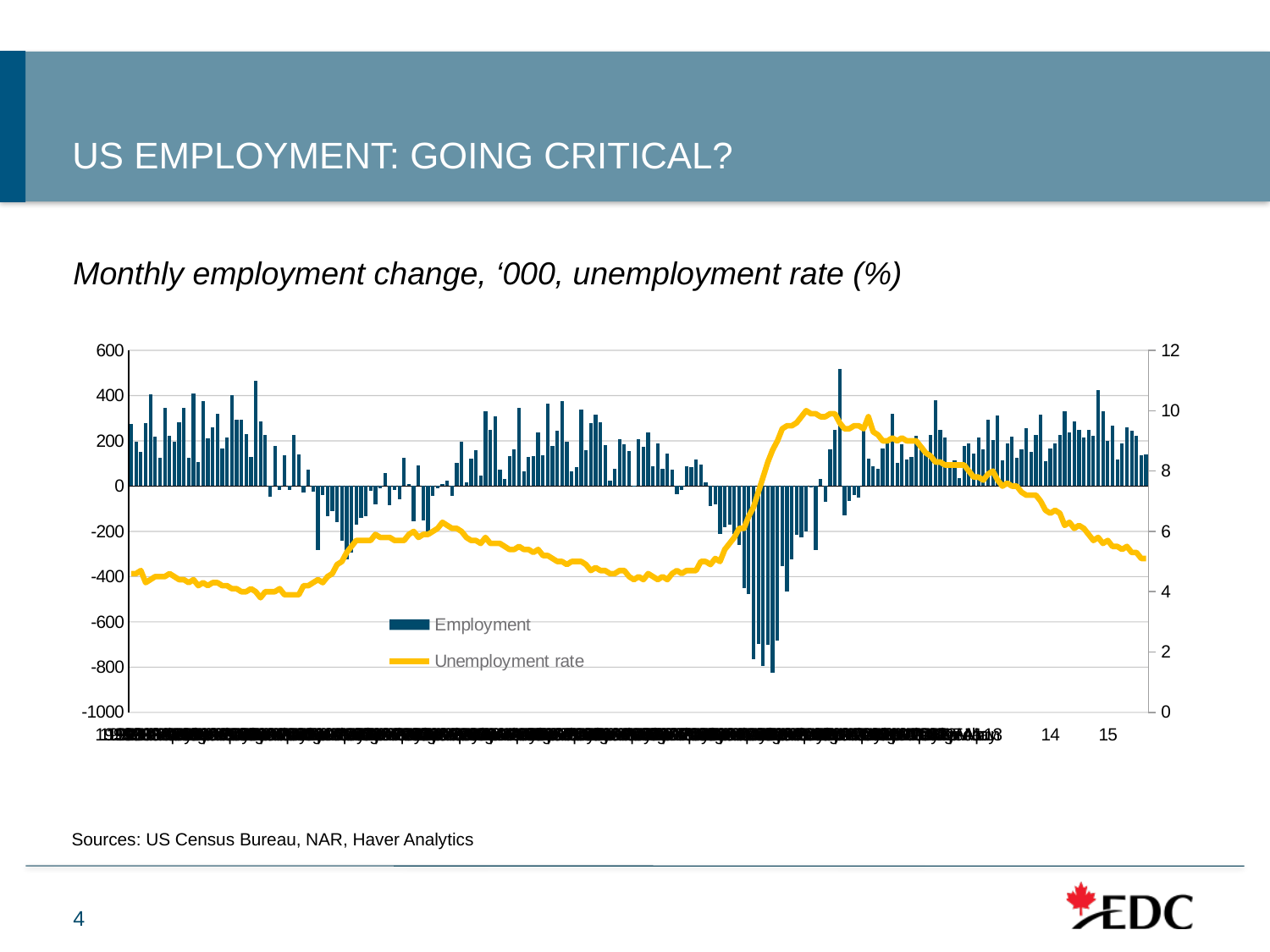
What kind of chart is shown on the slide? A combined bar and line chart Is the unemployment rate in 2015 greater or less than 4? greater Does the unemployment rate line fall or rise between 14 and 15 on the x axis? fall Which series is drawn as a yellow line in the chart? Unemployment rate Does the Employment series ever fall below -600 on the left axis? yes Does the Employment series ever exceed 600 on the left axis? no Are the Employment bars in 2015 mostly positive or negative? positive Which series is drawn as bars in the chart? Employment How many series does the chart's legend list? 2